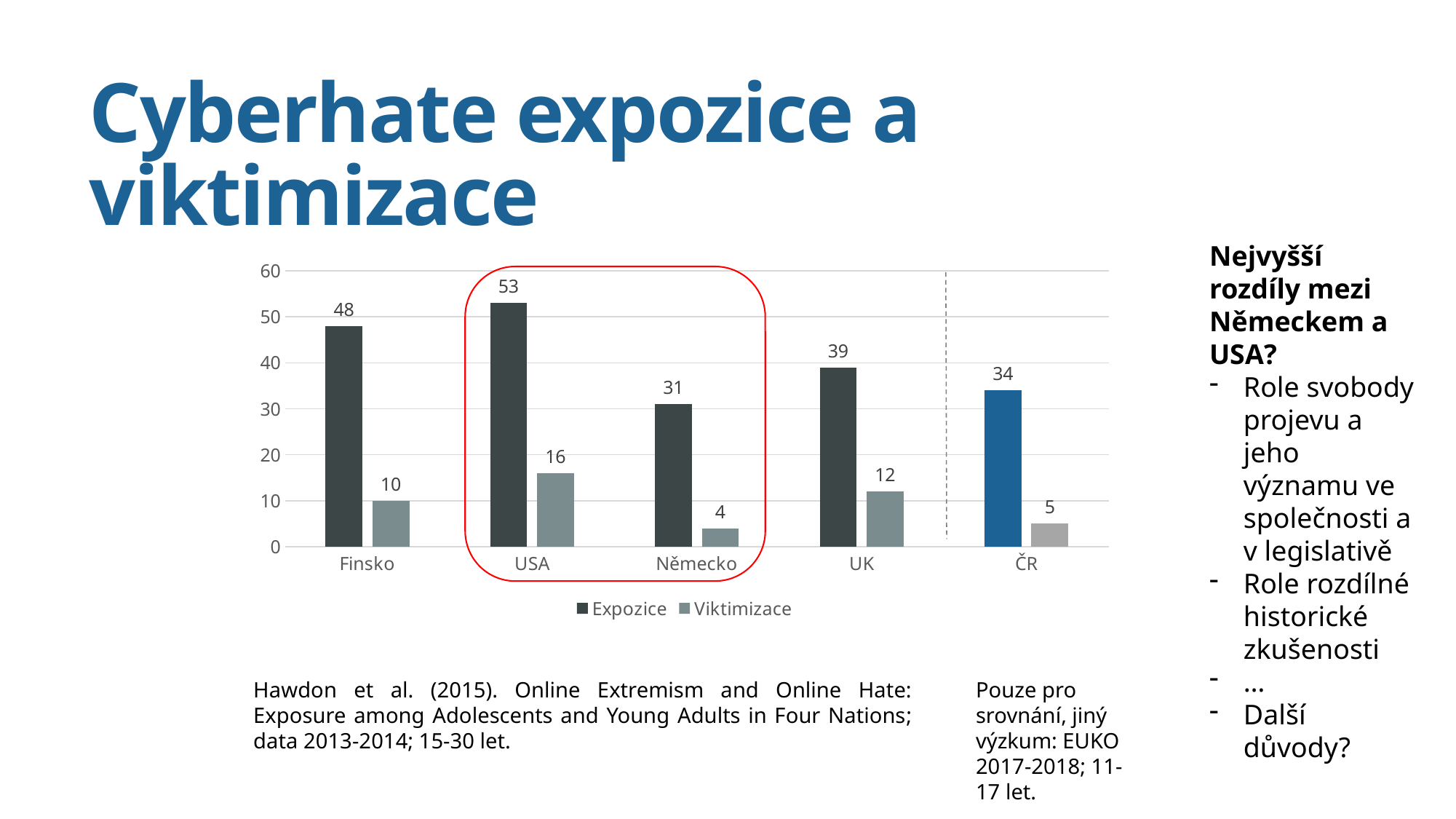
What is the difference between the Expozice values for USA and Německo? 22 Which is larger, the Viktimizace value for UK or for Finsko? UK What is the Expozice value for Finsko? 48 What kind of chart is shown on the slide? bar chart What is the Viktimizace value for Německo? 4 Which country has the highest Expozice value? USA Which country has the lowest Viktimizace value? Německo What is the Expozice value for ČR? 34 How many series does the legend list? 2 How many countries are shown on the x axis? 5 Which two countries are enclosed by the red rounded rectangle? USA and Německo Is the Expozice value for UK greater or less than 40? less